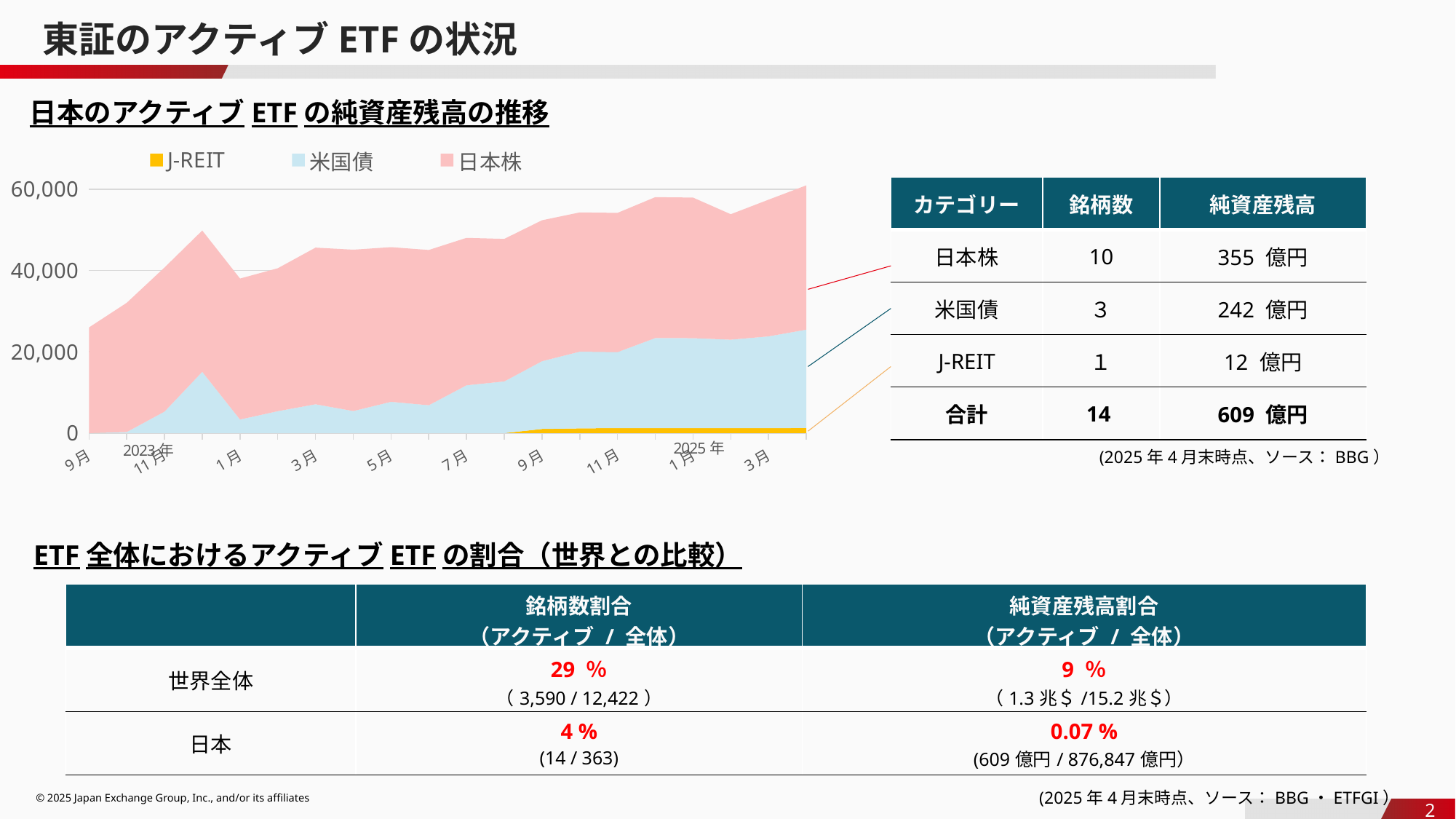
Does the total stacked value generally rise or fall from the left to the right of the chart? Rise Is the total stacked value at the left end of the chart (9月) greater or less than 40,000? less Which series are listed in the chart legend? J-REIT, 米国債, 日本株 What is the highest value shown on the chart's vertical axis? 60,000 Which series occupies the smallest area at the right end of the chart? J-REIT Which series occupies the largest area at the right end of the chart? 日本株 How many series does the chart legend list? 3 Which colour represents the J-REIT series in the chart? Yellow What kind of chart is shown on the slide? Stacked area chart Is the total stacked value at the left end of the chart (9月) greater or less than 20,000? greater Is the total stacked value at the right end of the chart (3月 2025) greater or less than 40,000? greater